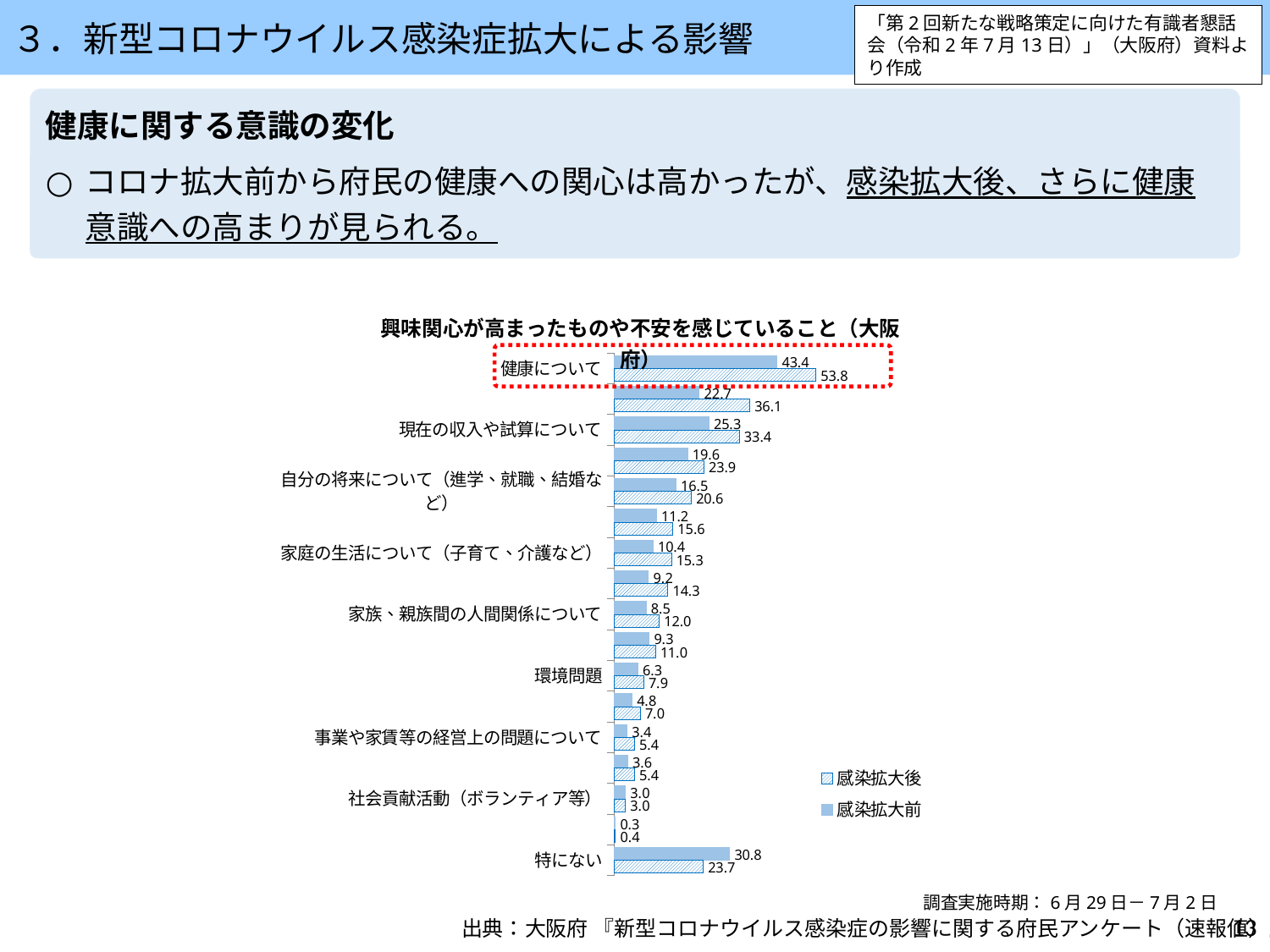
Which legend entry is shown with a hatched pattern? 感染拡大後 What type of chart is shown on the slide? bar chart What is the value for 社会貢献活動（ボランティア等） in the 感染拡大後 series? 3.0 What is the value for 健康について in the 感染拡大前 series? 43.4 For 特にない, which series has the larger value, 感染拡大後 or 感染拡大前? 感染拡大前 What is the difference between the 感染拡大後 and 感染拡大前 values for 健康について? 10.4 What is the value for 現在の収入や試算について in the 感染拡大後 series? 33.4 What is the difference between the 感染拡大後 and 感染拡大前 values for 家庭の生活について（子育て、介護など）? 4.9 How many series does the legend list? 2 What is the value for 健康について in the 感染拡大後 series? 53.8 What is the value for 特にない in the 感染拡大前 series? 30.8 Which category has the highest value in the 感染拡大後 series? 健康について